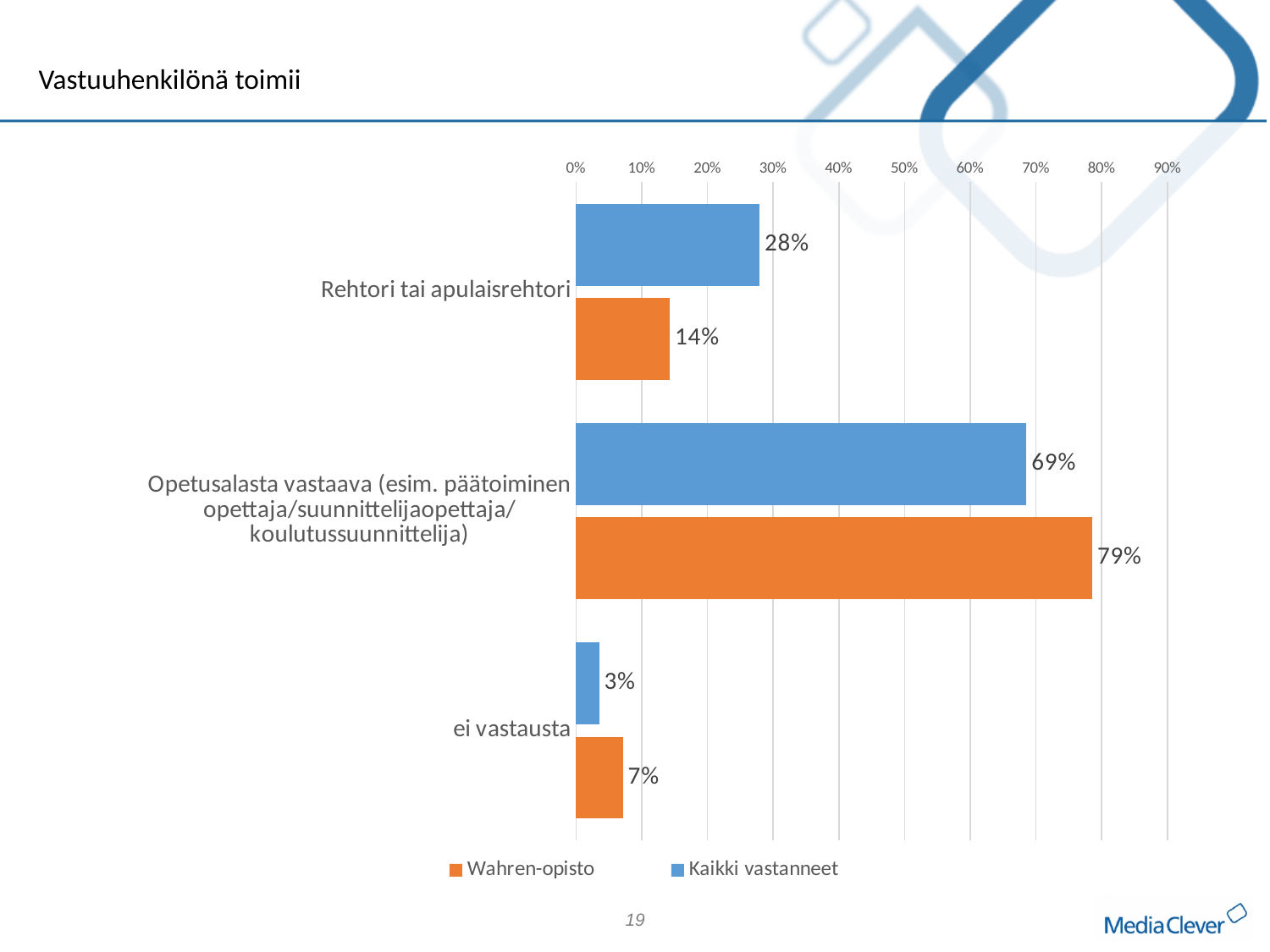
What is the value for Kaikki vastanneet in the 'ei vastausta' category? 3% In the 'Rehtori tai apulaisrehtori' category, which series has the larger value, Wahren-opisto or Kaikki vastanneet? Kaikki vastanneet How many categories are shown on the chart? 3 What is the value for Wahren-opisto in the 'Rehtori tai apulaisrehtori' category? 14% What is the difference between the Wahren-opisto and Kaikki vastanneet values in the 'Opetusalasta vastaava' category? 10% How many series does the legend list? 2 Which colour represents Wahren-opisto in the chart? Orange Which category has the highest value for Wahren-opisto? Opetusalasta vastaava (esim. päätoiminen opettaja/suunnittelijaopettaja/koulutussuunnittelija) What is the value for Kaikki vastanneet in the 'Rehtori tai apulaisrehtori' category? 28% Which category has the lowest value for Kaikki vastanneet? ei vastausta What is the value for Wahren-opisto in the 'Opetusalasta vastaava' category? 79% What kind of chart is shown on the slide? Bar chart